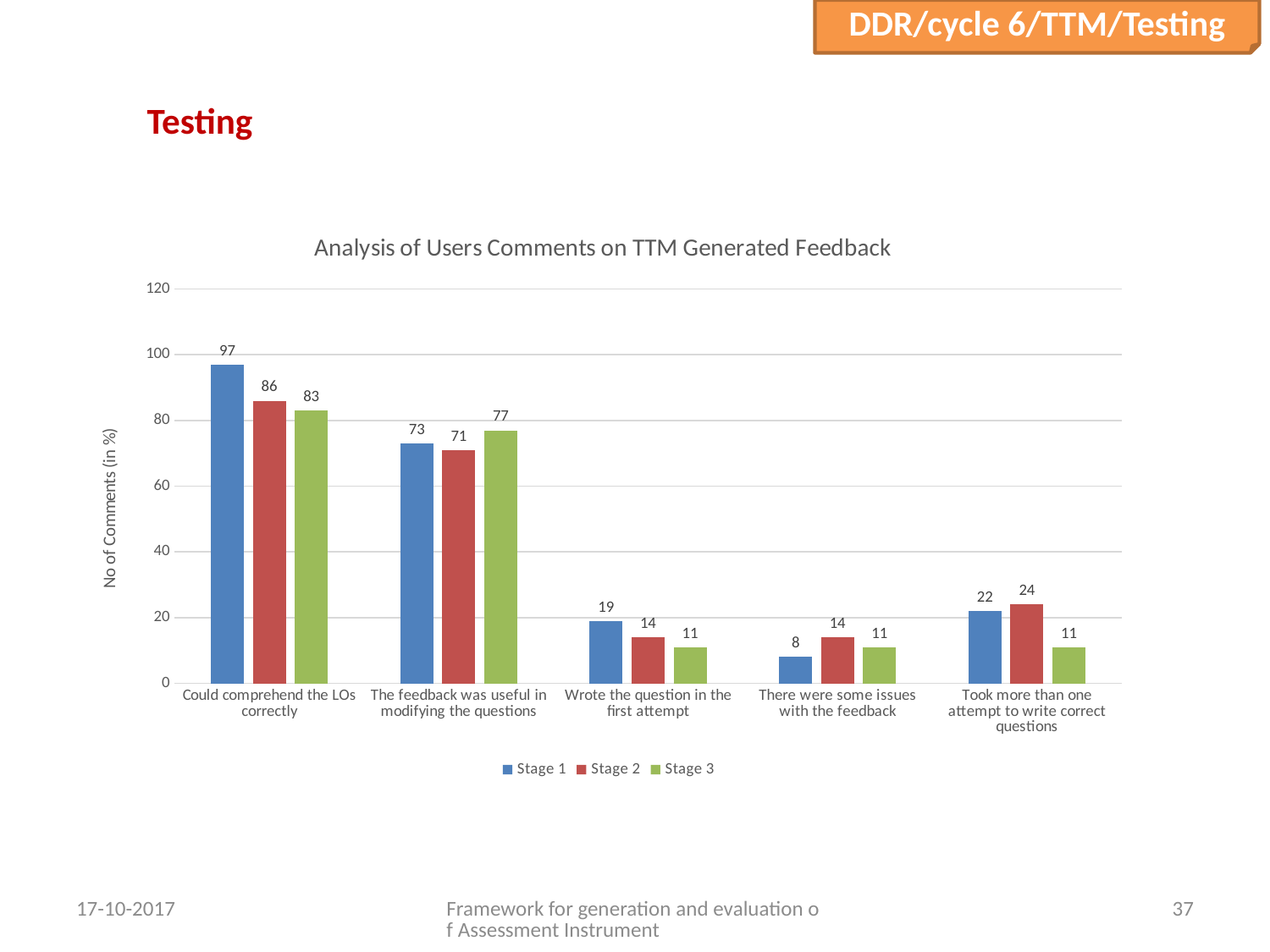
What is the Stage 1 value for "Could comprehend the LOs correctly"? 97 What is the title of the chart? Analysis of Users Comments on TTM Generated Feedback For "Wrote the question in the first attempt", which is larger: the Stage 1 value or the Stage 2 value? Stage 1 What is the Stage 2 value for "Took more than one attempt to write correct questions"? 24 What is the Stage 3 value for "The feedback was useful in modifying the questions"? 77 Which category has the highest Stage 1 value? Could comprehend the LOs correctly How many series does the legend list? 3 What kind of chart is shown on the slide? Bar chart Which category has the lowest Stage 1 value? There were some issues with the feedback What is the difference between the Stage 1 and Stage 3 values for "Could comprehend the LOs correctly"? 14 Is the Stage 2 value for "The feedback was useful in modifying the questions" greater or less than 60? greater How many categories are shown on the x axis? 5